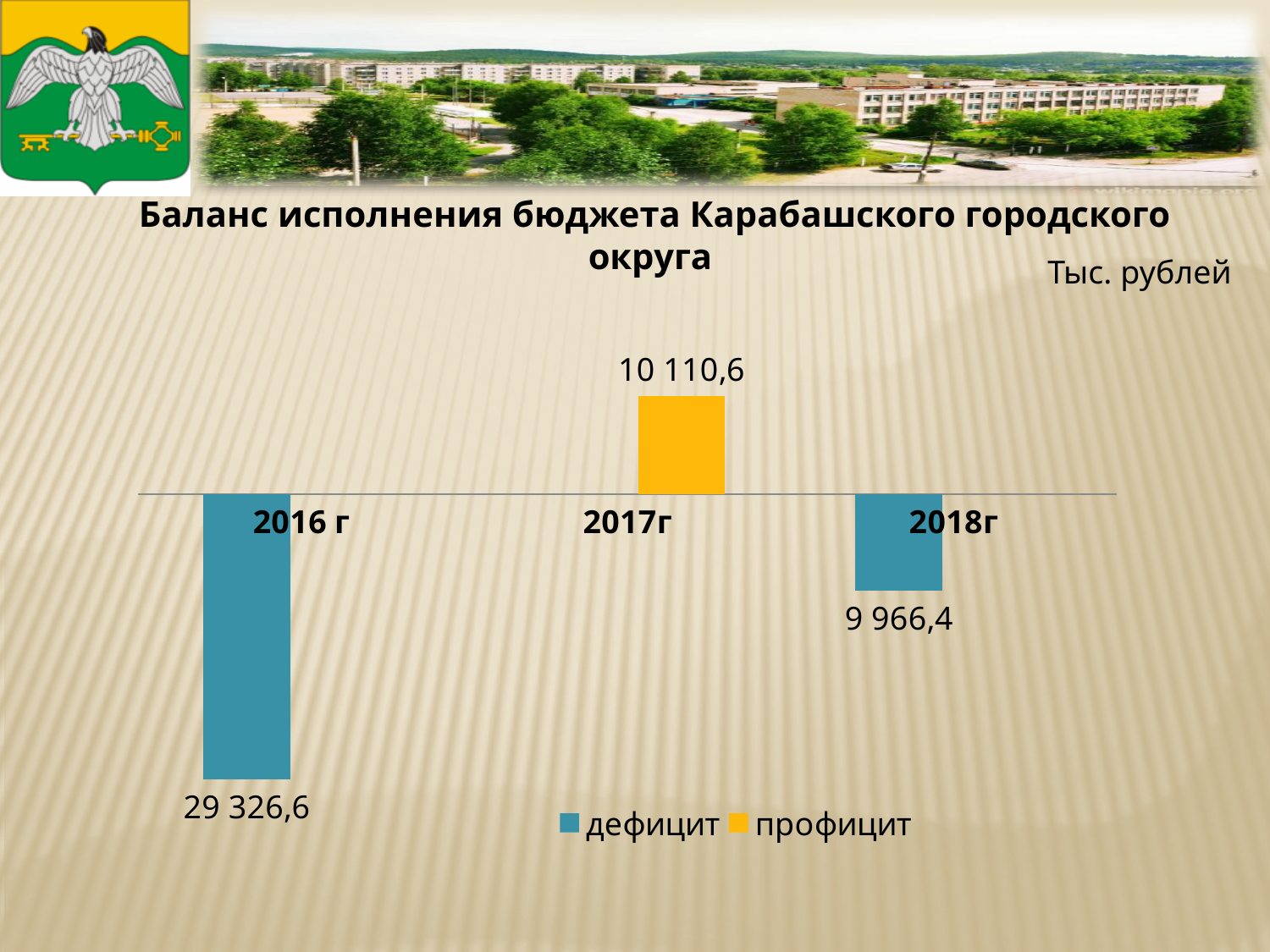
What is the difference between the 2017г surplus and the 2018г deficit? 144,2 What is the deficit value shown for 2016 г? 29 326,6 How many years are shown on the chart? 3 How many series does the legend list? 2 What kind of chart is shown on the slide? Bar chart Which year has the largest bar in the chart? 2016 г Which year has the smallest bar in the chart? 2018г What is the surplus (профицит) value shown for 2017г? 10 110,6 Which is larger: the 2017г surplus or the 2018г deficit? 2017г surplus By how much does the 2016 г deficit exceed the 2018г deficit? 19 360,2 What is the deficit value shown for 2018г? 9 966,4 In what units are the chart values given? Тыс. рублей